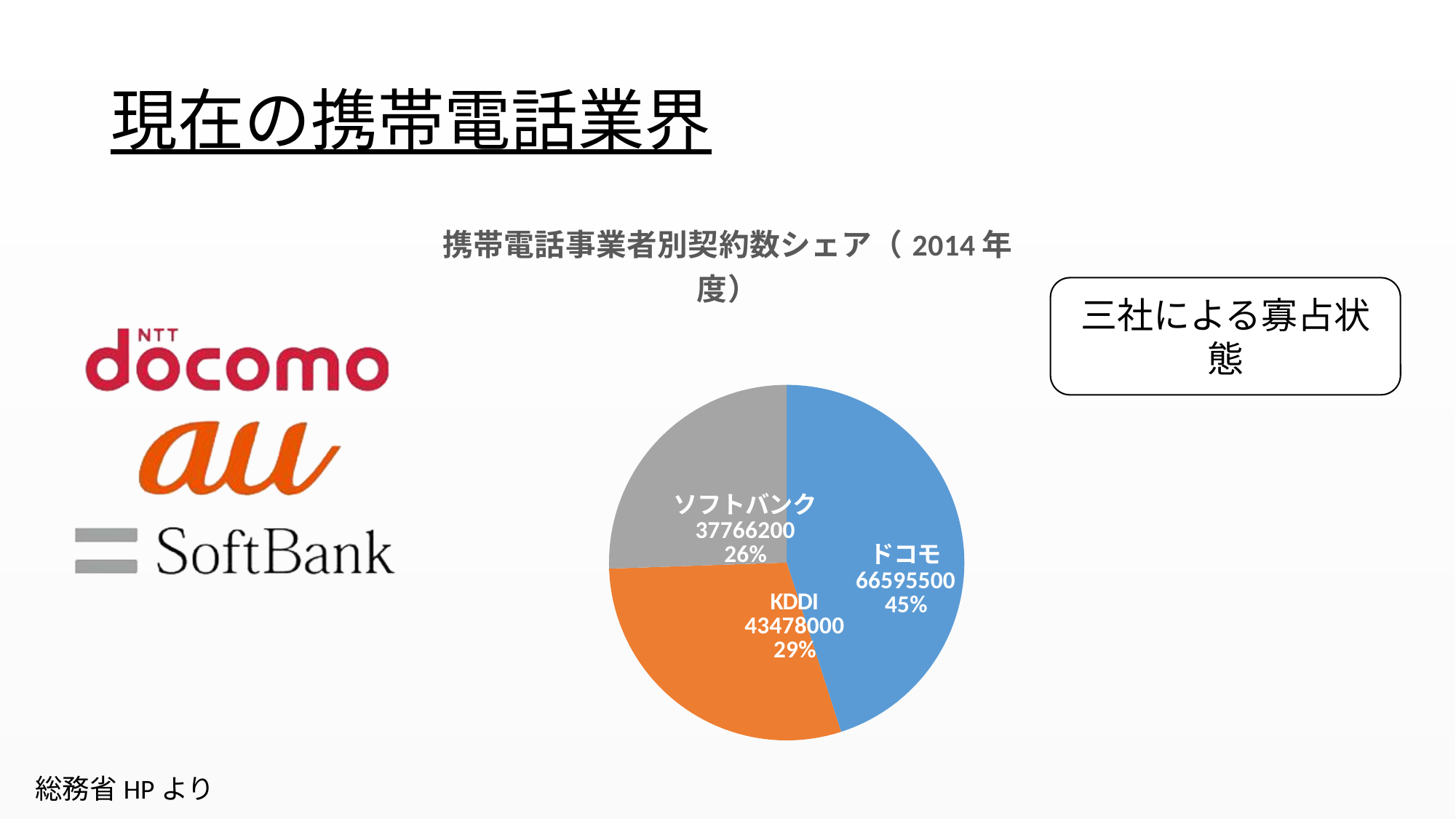
What share of the pie does ドコモ hold? 45% How many slices does the pie chart have? 3 What is the difference between the values for ドコモ and KDDI? 23117500 What is the title of the pie chart? 携帯電話事業者別契約数シェア（2014年度） What is the value for ドコモ in the pie chart? 66595500 What kind of chart is shown on the slide? pie chart What is the value for KDDI in the pie chart? 43478000 What share of the pie does ソフトバンク hold? 26% Which carrier has the smallest slice of the pie? ソフトバンク Which is larger, the value for KDDI or the value for ソフトバンク? KDDI What is the value for ソフトバンク in the pie chart? 37766200 Which carrier has the largest slice of the pie? ドコモ